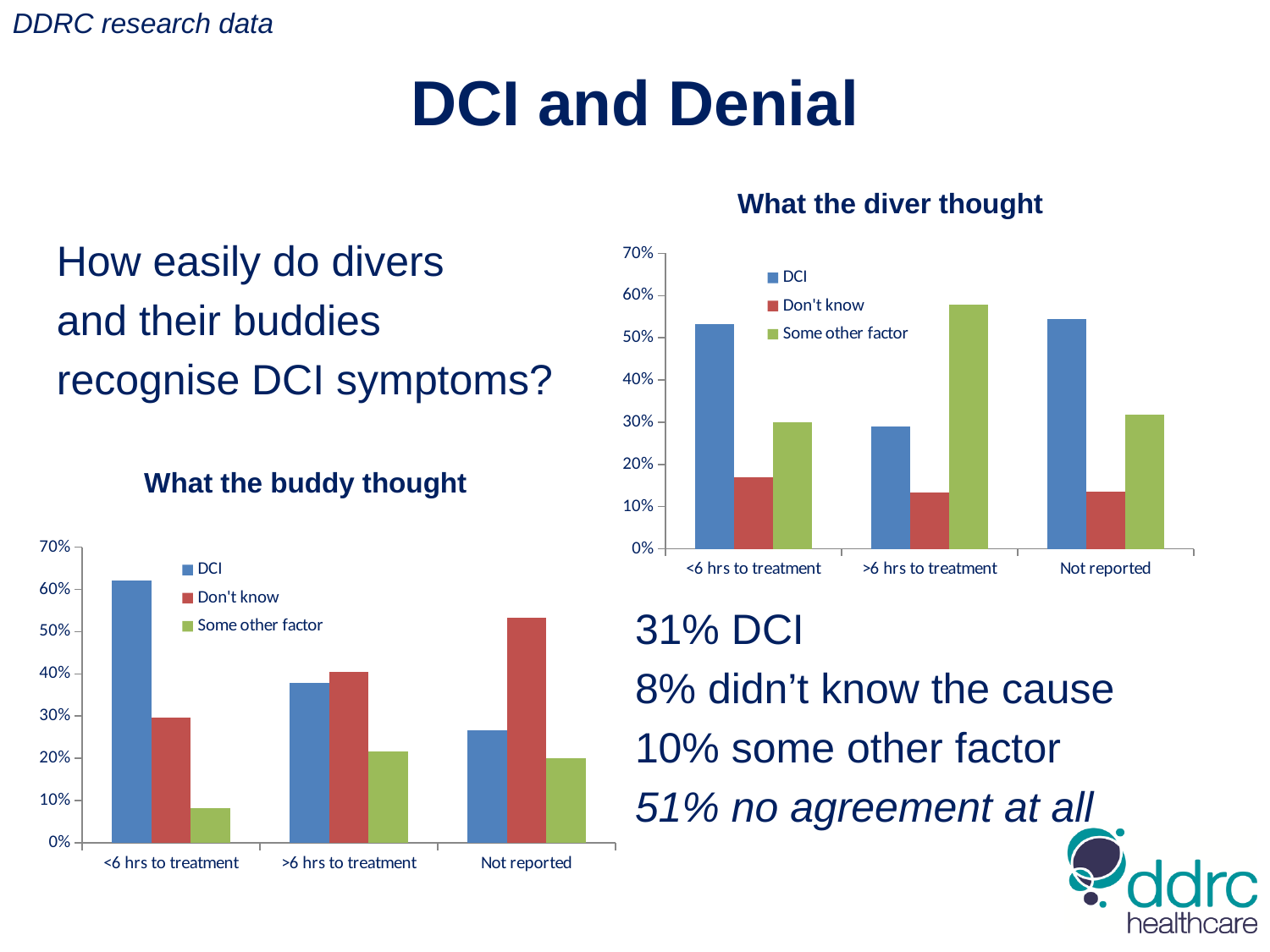
In the 'What the diver thought' chart, what colour represents the 'Some other factor' series? green In the 'What the diver thought' chart, which is larger for '<6 hrs to treatment': DCI or Don't know? DCI In the 'What the buddy thought' chart, is the 'Some other factor' value for '<6 hrs to treatment' greater or less than 10%? less In the 'What the buddy thought' chart, which series has the highest value for 'Not reported'? Don't know In the 'What the buddy thought' chart, how many categories are shown on the x axis? 3 In the 'What the buddy thought' chart, how many series does the legend list? 3 In the 'What the diver thought' chart, which series has the highest value for '>6 hrs to treatment'? Some other factor In the 'What the diver thought' chart, is the 'Some other factor' value for '>6 hrs to treatment' greater or less than 50%? greater In the 'What the buddy thought' chart, what kind of chart is shown? bar chart In the 'What the buddy thought' chart, which category has the lowest DCI value? Not reported In the 'What the buddy thought' chart, is the DCI value for '<6 hrs to treatment' greater or less than 60%? greater